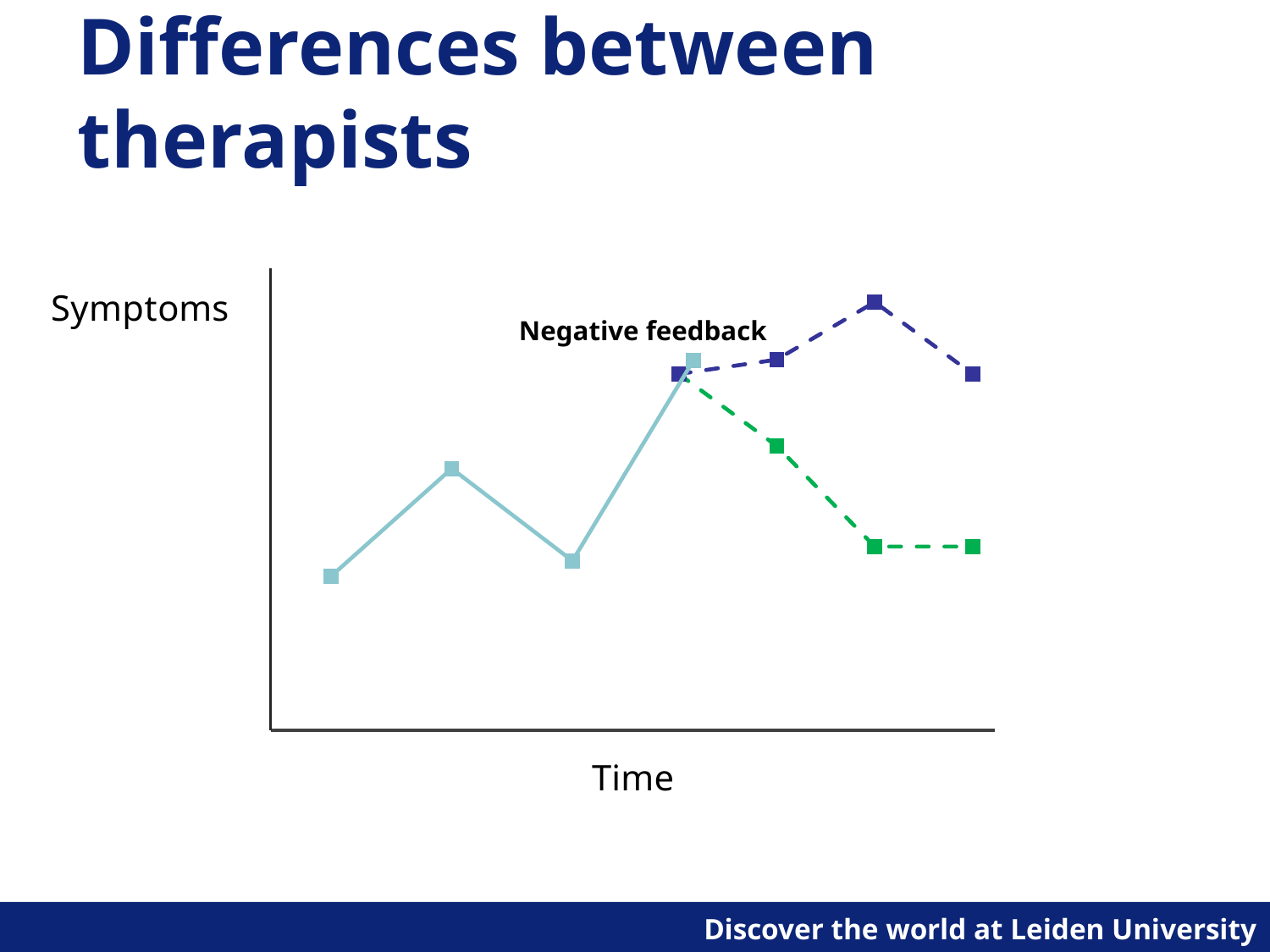
Is the second point of the solid light blue line higher or lower than its third point? higher What does the vertical axis of the chart represent? Symptoms What kind of chart is shown on the slide? line chart Which line contains the lowest point on the chart? the solid light blue line Does the solid light blue line end higher or lower than where it starts? higher Which line reaches the highest point on the chart? the dark blue dashed line How many separate lines are plotted on the chart? 3 At the right end of the chart, is the dark blue dashed line higher or lower than the green dashed line? higher After the 'Negative feedback' point, does the green dashed line rise or fall? fall What text annotation is written above the point where the lines split? Negative feedback How many data points are on the solid light blue line? 4